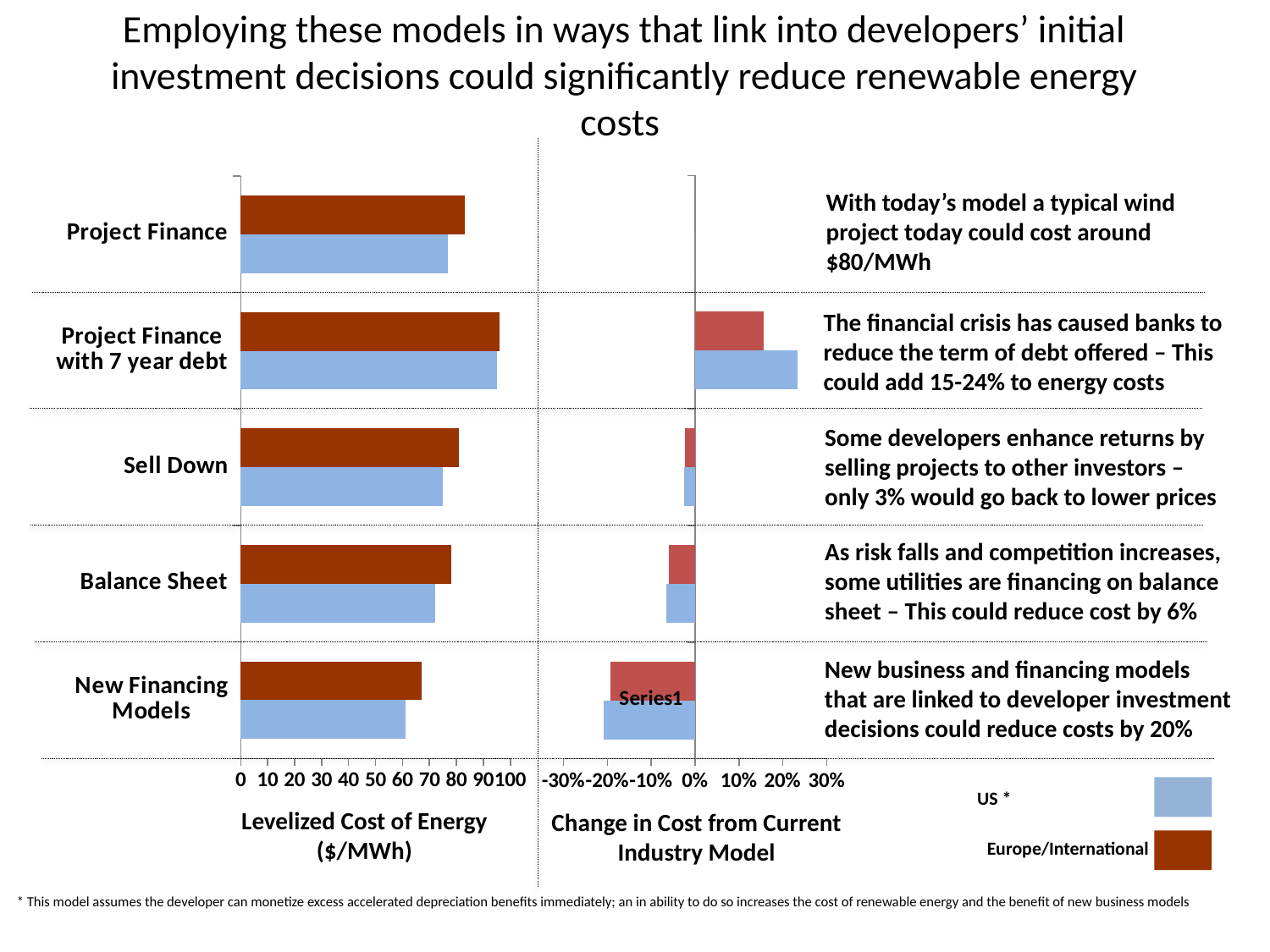
In the 'Levelized Cost of Energy ($/MWh)' chart, is the Europe/International value for Project Finance with 7 year debt greater or less than 90? greater In the 'Change in Cost from Current Industry Model' chart, is the US value for Project Finance with 7 year debt greater or less than 20%? greater In the 'Change in Cost from Current Industry Model' chart, is the Europe/International value for New Financing Models greater or less than -10%? less In the 'Levelized Cost of Energy ($/MWh)' chart, which category has the lowest US value? New Financing Models Which colour represents the US series in the legend? blue How many financing model categories are shown in the 'Levelized Cost of Energy ($/MWh)' chart? 5 In the 'Change in Cost from Current Industry Model' chart, which category has the largest positive change in cost? Project Finance with 7 year debt How many series does the legend list for the charts? 2 In the 'Levelized Cost of Energy ($/MWh)' chart, for Project Finance, which series has the larger value: US or Europe/International? Europe/International In the 'Levelized Cost of Energy ($/MWh)' chart, which category has the highest Europe/International value? Project Finance with 7 year debt What kind of chart is the 'Levelized Cost of Energy ($/MWh)' chart on the left? bar chart